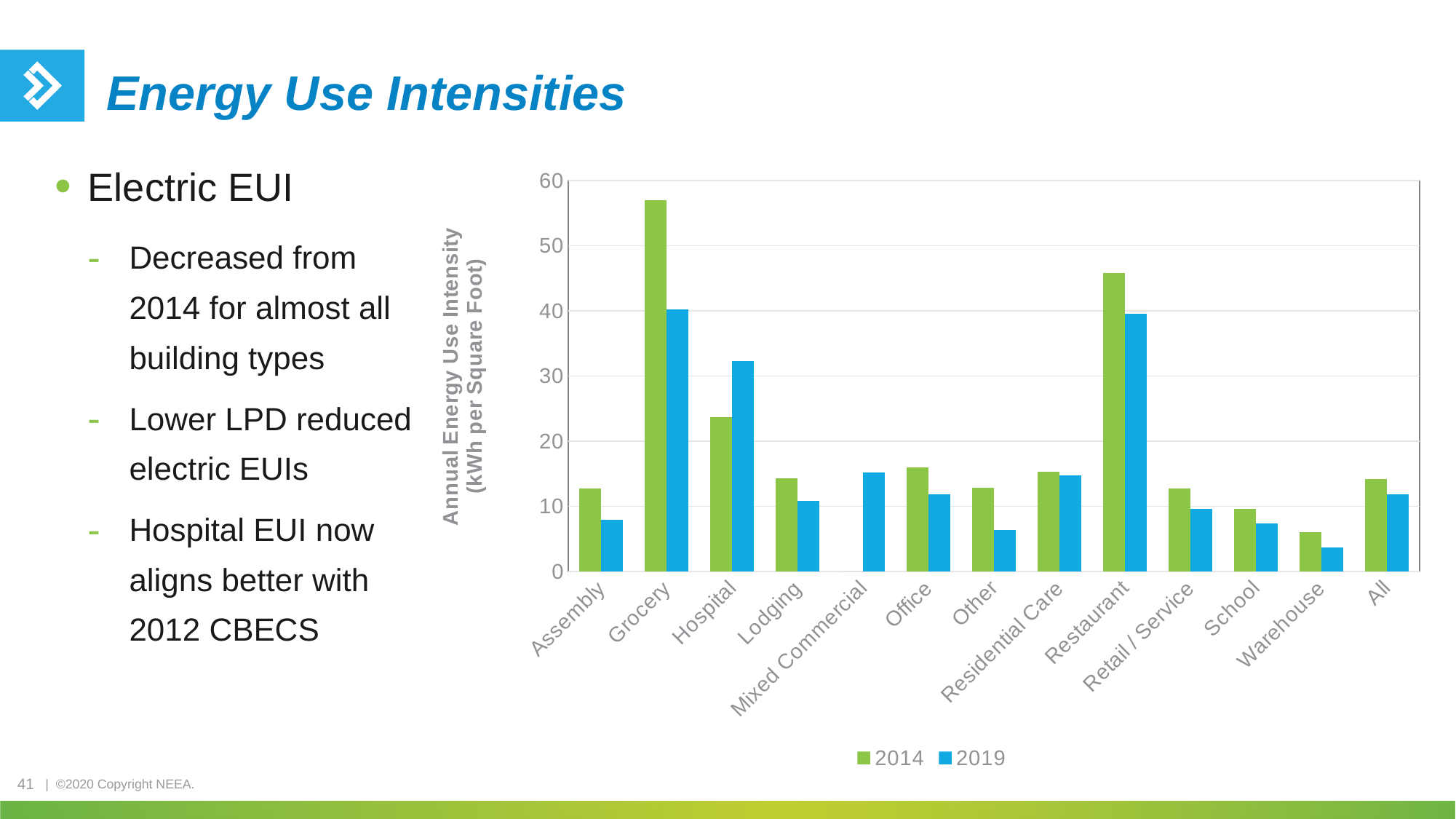
Is the 2014 value for Grocery greater or less than 50? greater Is the 2019 value for Hospital greater or less than 30? greater For Hospital, which is larger, the 2014 value or the 2019 value? 2019 Is the 2014 value for Restaurant greater or less than 40? greater What is the title of the y axis? Annual Energy Use Intensity (kWh per Square Foot) How many series does the legend list? 2 What kind of chart is shown on the slide? bar chart Which category has the lowest 2019 value? Warehouse Which category has the highest 2014 value? Grocery How many building-type categories are shown on the x axis? 13 Which category has the highest 2019 value? Grocery